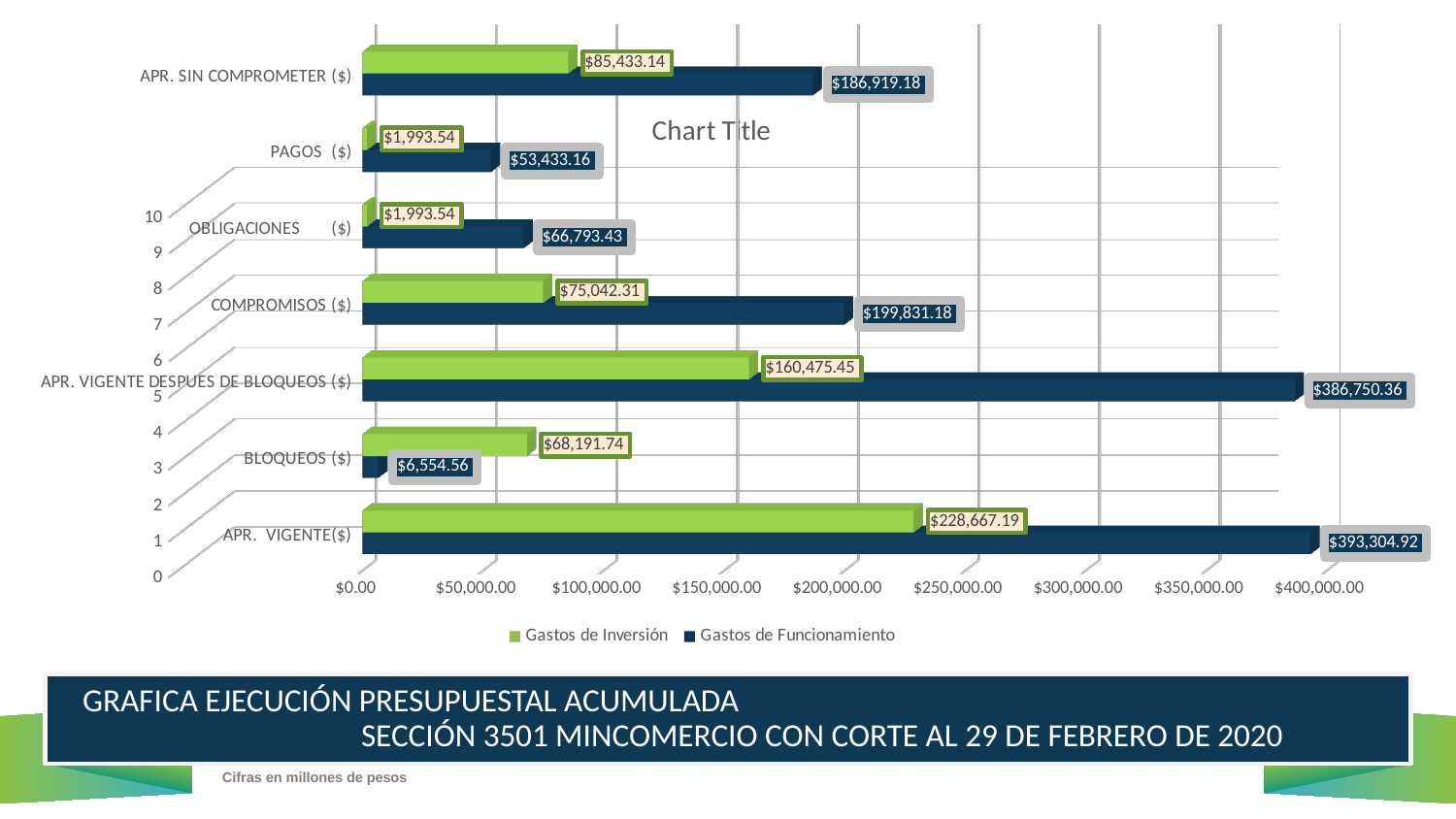
What is the difference between Gastos de Funcionamiento and Gastos de Inversión for APR. VIGENTE($)? $164,637.73 What is the difference between Gastos de Inversión and Gastos de Funcionamiento for BLOQUEOS ($)? $61,637.18 How many series does the legend list? 2 Which category has the lowest Gastos de Funcionamiento value? BLOQUEOS ($) What is the Gastos de Funcionamiento value for PAGOS ($)? $53,433.16 Which category has the highest Gastos de Funcionamiento value? APR. VIGENTE($) What is the Gastos de Funcionamiento value for APR. VIGENTE($)? $393,304.92 For COMPROMISOS ($), which series has the larger value, Gastos de Inversión or Gastos de Funcionamiento? Gastos de Funcionamiento How many categories are shown on the chart? 7 What is the Gastos de Inversión value for BLOQUEOS ($)? $68,191.74 What kind of chart is shown on the slide? Bar chart What is the Gastos de Inversión value for APR. VIGENTE DESPUÉS DE BLOQUEOS ($)? $160,475.45